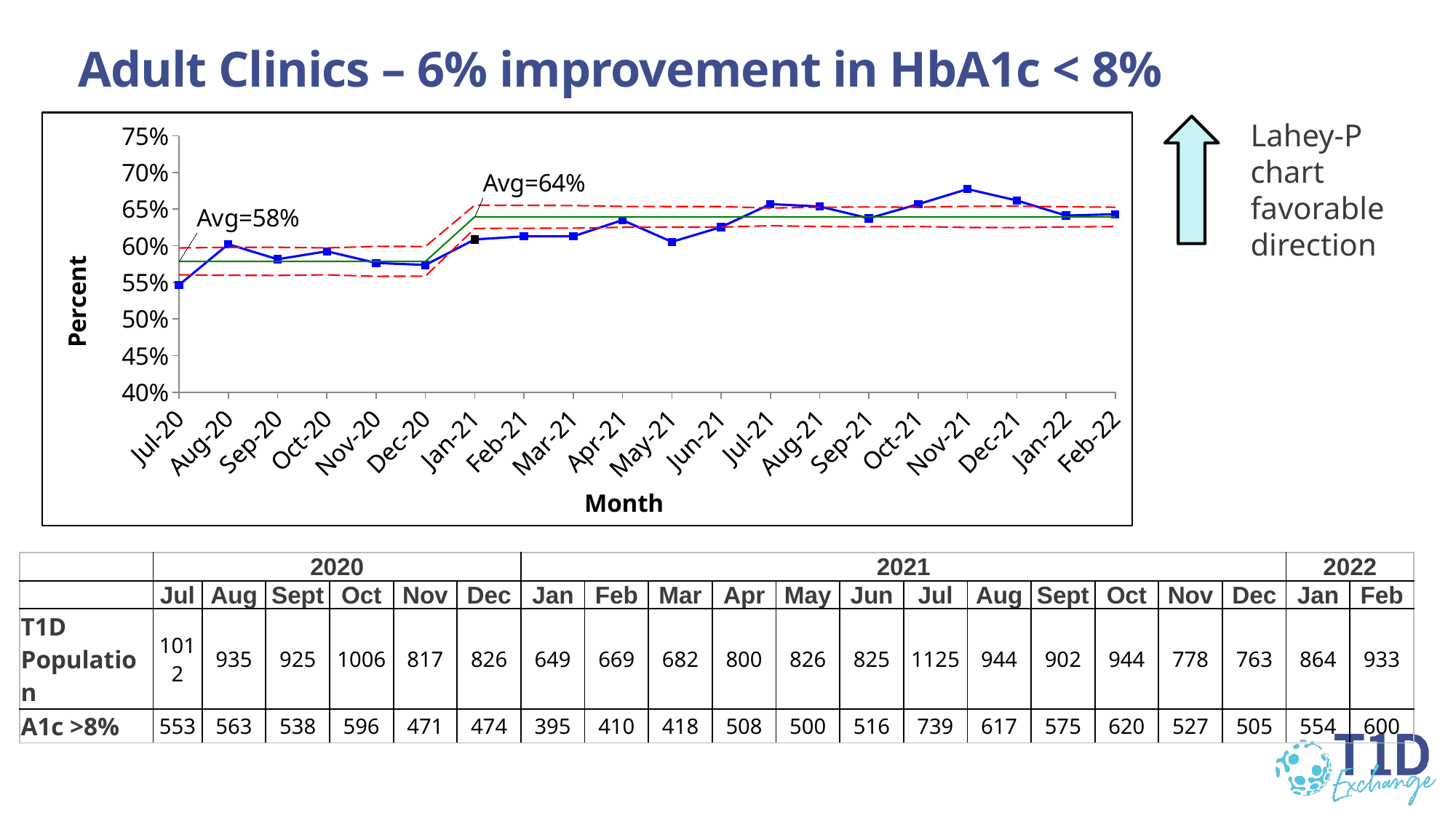
Which month has the lowest plotted value on the chart? Jul-20 Is the value for Jul-20 greater or less than 60%? less Is the value for Nov-21 greater or less than 65%? greater Which is larger, the value for Jul-21 or the value for Dec-20? Jul-21 What average value is annotated for the second period of the chart (from Jan-21 onward)? Avg=64% What is the label on the vertical axis of the chart? Percent Is the value for Jan-21 greater or less than 65%? less What kind of chart is shown on the slide? line chart Overall, do the plotted values rise or fall from Jul-20 to Feb-22? rise How many monthly data points are plotted on the chart? 20 What average value is annotated for the first period of the chart (Jul-20 to Dec-20)? Avg=58% Which month has the highest plotted value on the chart? Nov-21